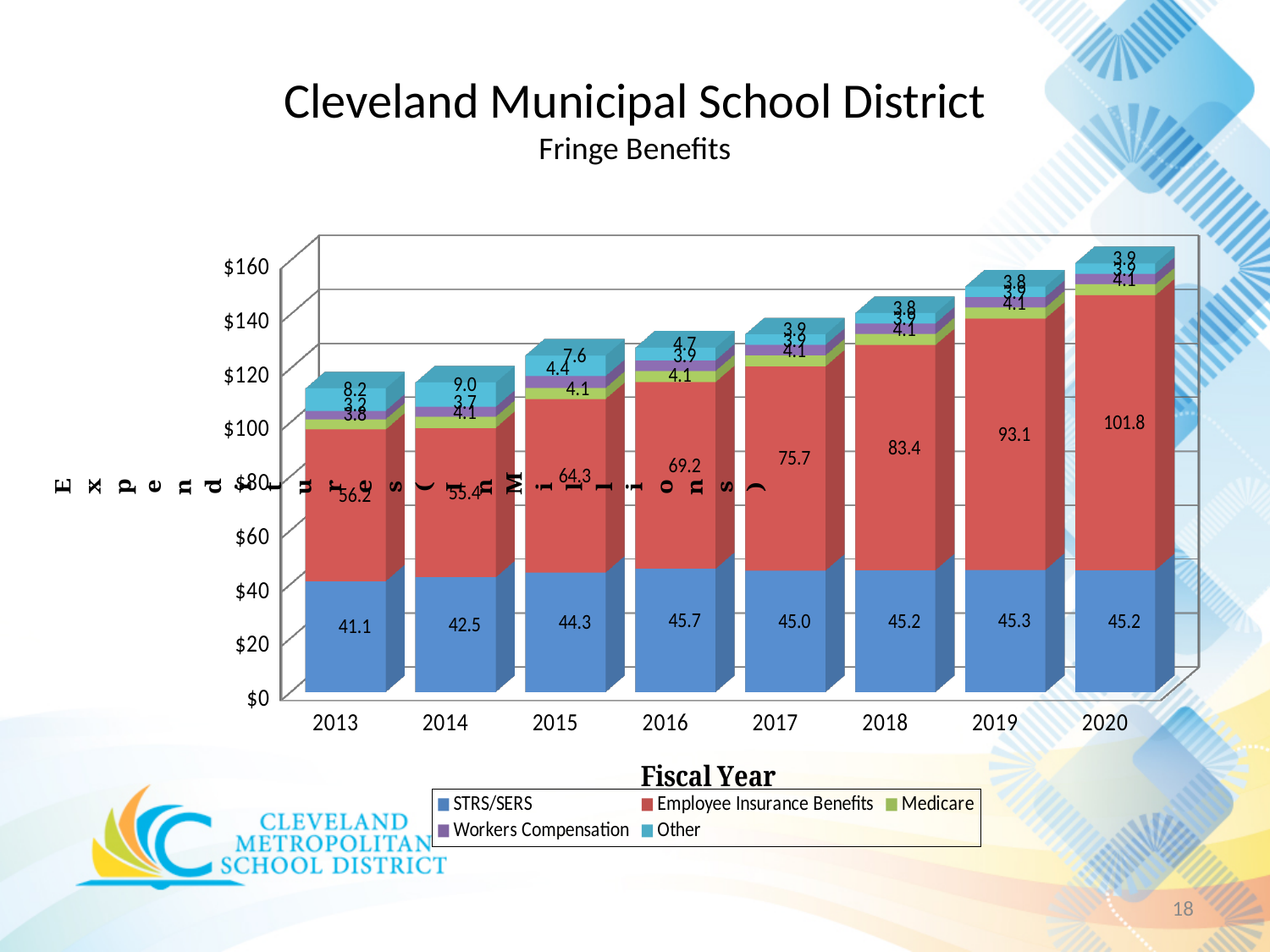
How many series does the legend list? 5 What is the difference between the Employee Insurance Benefits values for 2020 and 2013? 45.6 Which fiscal year has the lowest STRS/SERS value? 2013 What is the Other value for fiscal year 2014? 9.0 What is the Employee Insurance Benefits value for fiscal year 2016? 69.2 Is the total stacked value for fiscal year 2020 greater or less than $140? greater What is the STRS/SERS value for fiscal year 2013? 41.1 Which is larger, the STRS/SERS value for 2016 or for 2014? 2016 What kind of chart is shown on the slide? Stacked bar chart Which fiscal year has the highest Employee Insurance Benefits value? 2020 What is the Employee Insurance Benefits value for fiscal year 2020? 101.8 How many fiscal years are shown on the x axis? 8